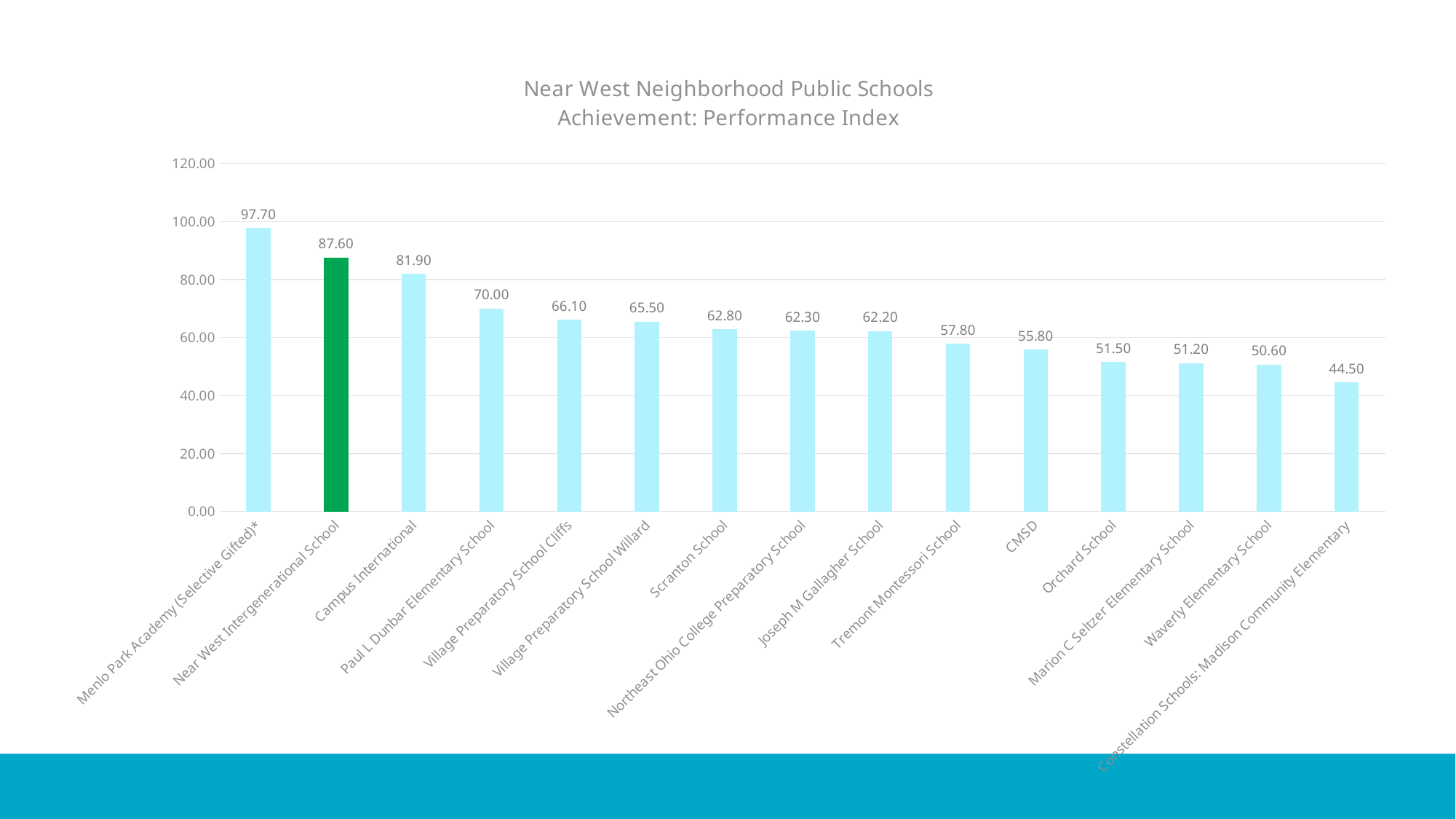
What is the Performance Index value for Near West Intergenerational School? 87.60 Which school has the lowest Performance Index? Constellation Schools: Madison Community Elementary Which school has the highest Performance Index? Menlo Park Academy (Selective Gifted)* What is the Performance Index value for Campus International? 81.90 Which has a higher Performance Index, Paul L Dunbar Elementary School or Tremont Montessori School? Paul L Dunbar Elementary School What is the Performance Index value for Scranton School? 62.80 What is the Performance Index value for CMSD? 55.80 What is the difference between the Performance Index of Near West Intergenerational School and CMSD? 31.80 Is the value for Orchard School greater or less than 60.00? less What kind of chart is shown on the slide? Bar chart Which bar is highlighted in green? Near West Intergenerational School How many schools are shown on the chart? 15